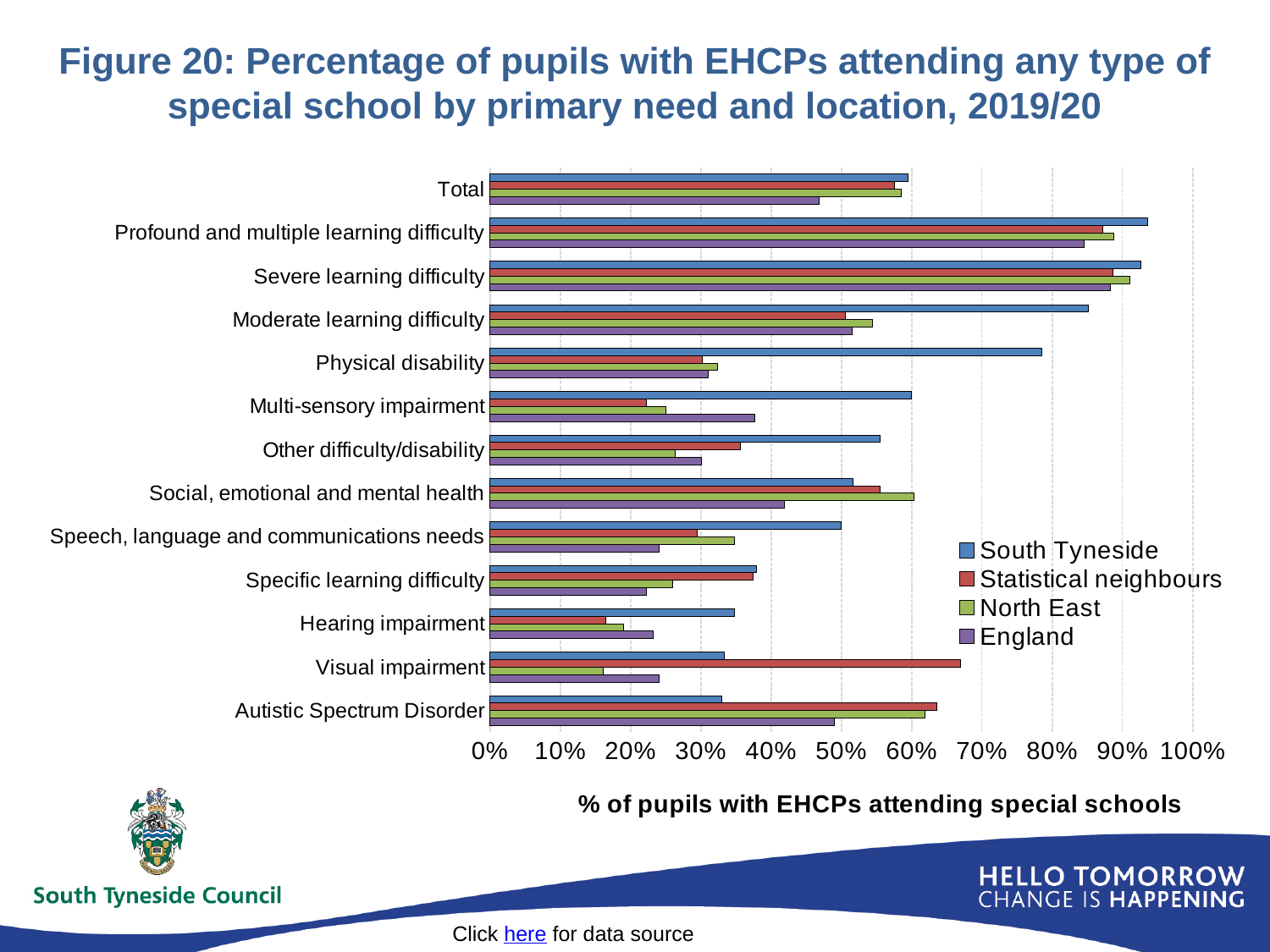
Is the Statistical neighbours value for Visual impairment greater or less than 60%? greater What is the title of the horizontal axis? % of pupils with EHCPs attending special schools Is the England value for Total greater or less than 50%? less What type of chart is shown on the slide? Bar chart Which colour represents England in the legend? Purple For Visual impairment, which is larger: South Tyneside or Statistical neighbours? Statistical neighbours Which category has the lowest value for Statistical neighbours? Hearing impairment How many primary need categories (including Total) are plotted on the chart? 13 How many series does the legend list? 4 Is the South Tyneside value for Physical disability greater or less than 70%? greater For Autistic Spectrum Disorder, which is larger: South Tyneside or North East? North East For Moderate learning difficulty, which is larger: South Tyneside or England? South Tyneside